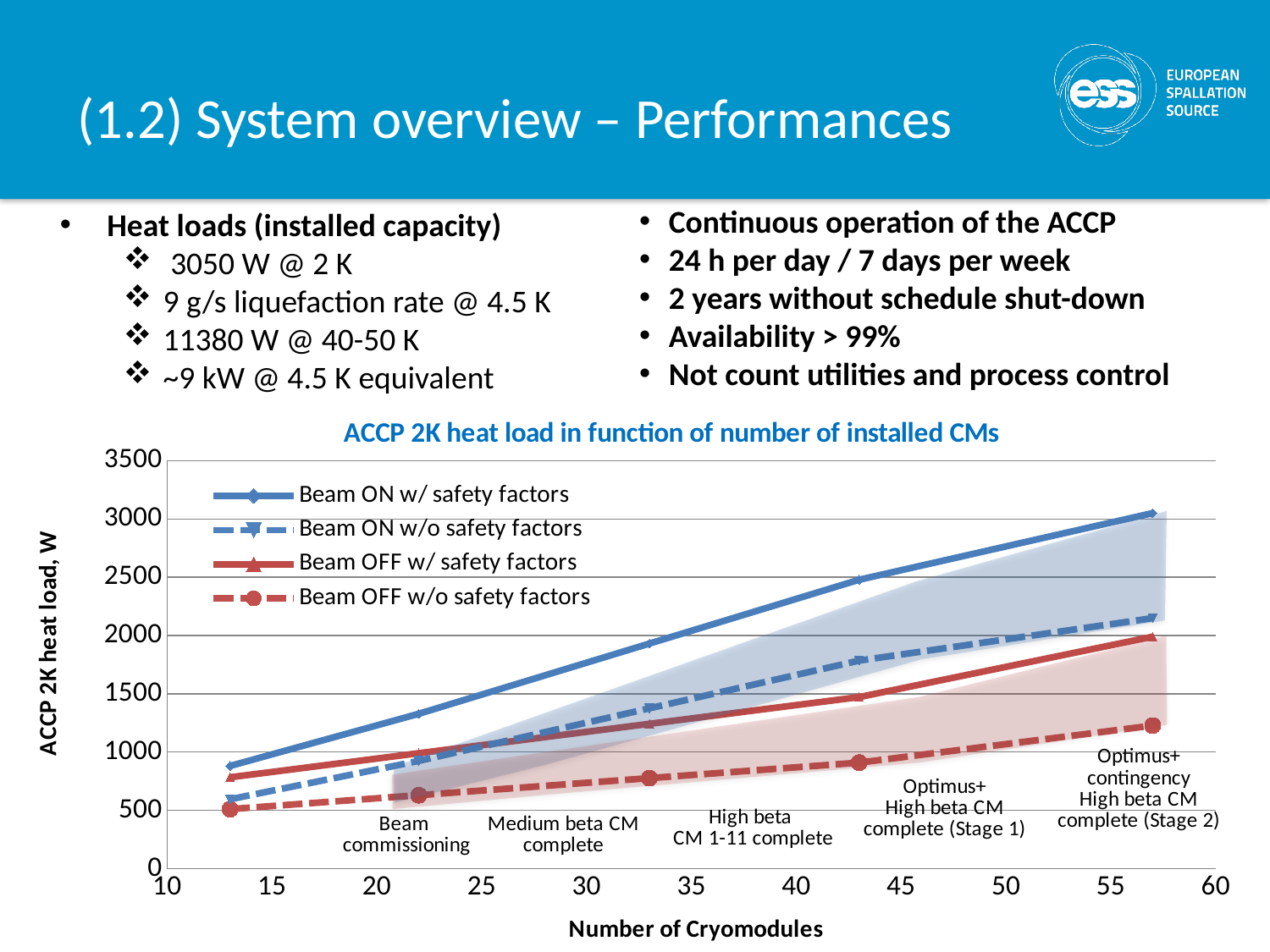
What is the title of the chart? ACCP 2K heat load in function of number of installed CMs Is the value for Beam ON w/ safety factors at 57 cryomodules greater or less than 2500? greater How many series does the chart legend list? 4 Which series has the lowest value at 57 cryomodules? Beam OFF w/o safety factors Is the value for Beam OFF w/o safety factors at 57 cryomodules greater or less than 1500? less Is the value for Beam ON w/o safety factors at 57 cryomodules greater or less than 2500? less At 33 cryomodules, which is larger: Beam ON w/ safety factors or Beam OFF w/o safety factors? Beam ON w/ safety factors Does the Beam ON w/ safety factors series rise or fall as the number of cryomodules increases? rise What is the label of the chart's x axis? Number of Cryomodules Which series has the highest value at 57 cryomodules? Beam ON w/ safety factors What kind of chart is shown on the slide? line chart